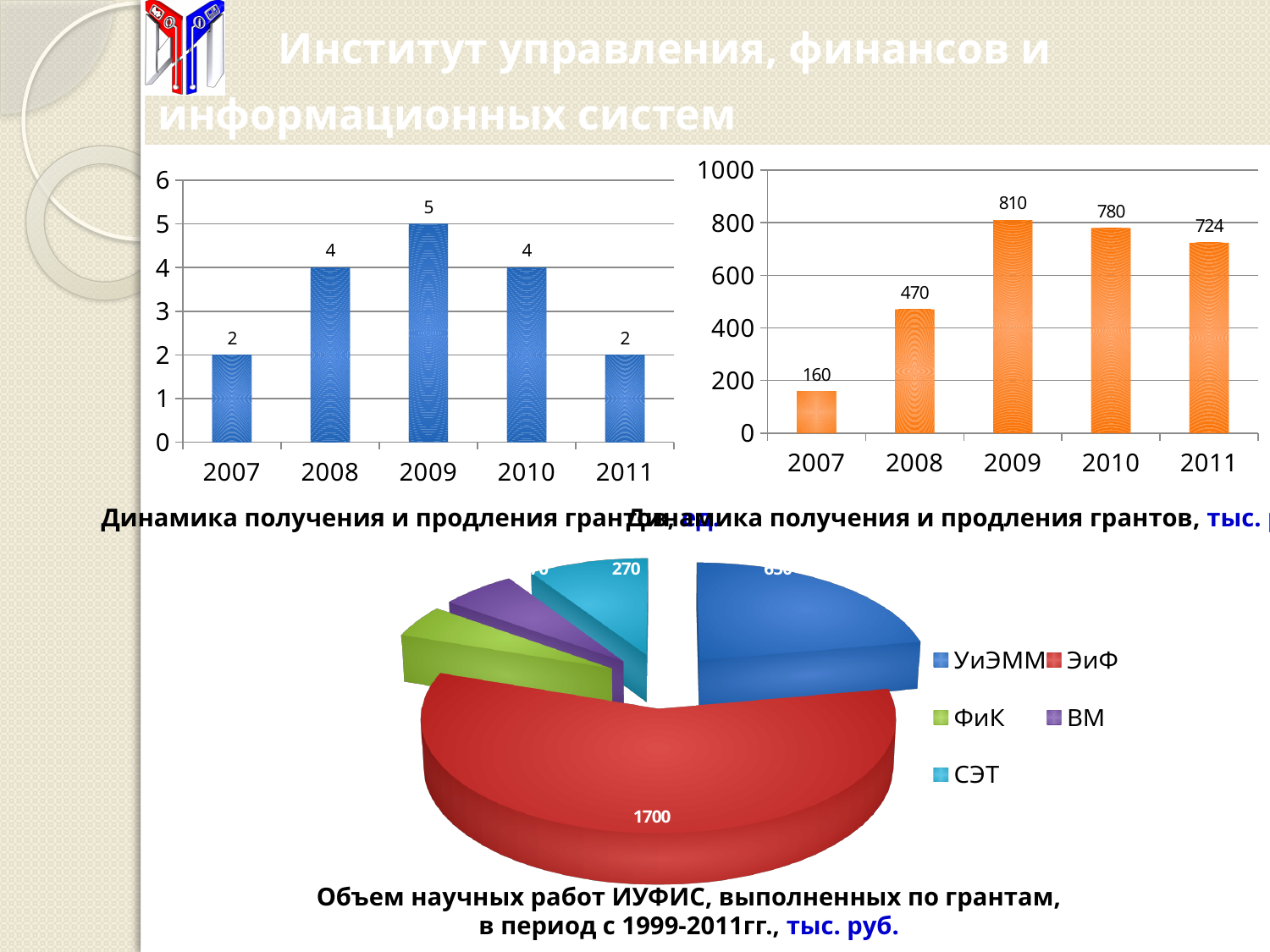
In the bottom pie chart, what is the value for ЭиФ? 1700 In the top-right bar chart, what is the difference between the values for 2009 and 2011? 86 In the top-left bar chart, what is the value for 2009? 5 In the top-right bar chart, which year has the lowest value? 2007 In the top-left bar chart, which year has the highest value? 2009 How many series does the legend of the bottom pie chart list? 5 How many years are shown on the x axis of the top-left bar chart? 5 What kind of chart is the bottom chart on the slide? pie chart In the top-right bar chart, what is the value for 2008? 470 In the top-right bar chart, do the values rise or fall from 2009 to 2011? fall In the top-right bar chart, which is larger, the value for 2010 or the value for 2011? 2010 In the top-left bar chart, what is the difference between the values for 2009 and 2007? 3